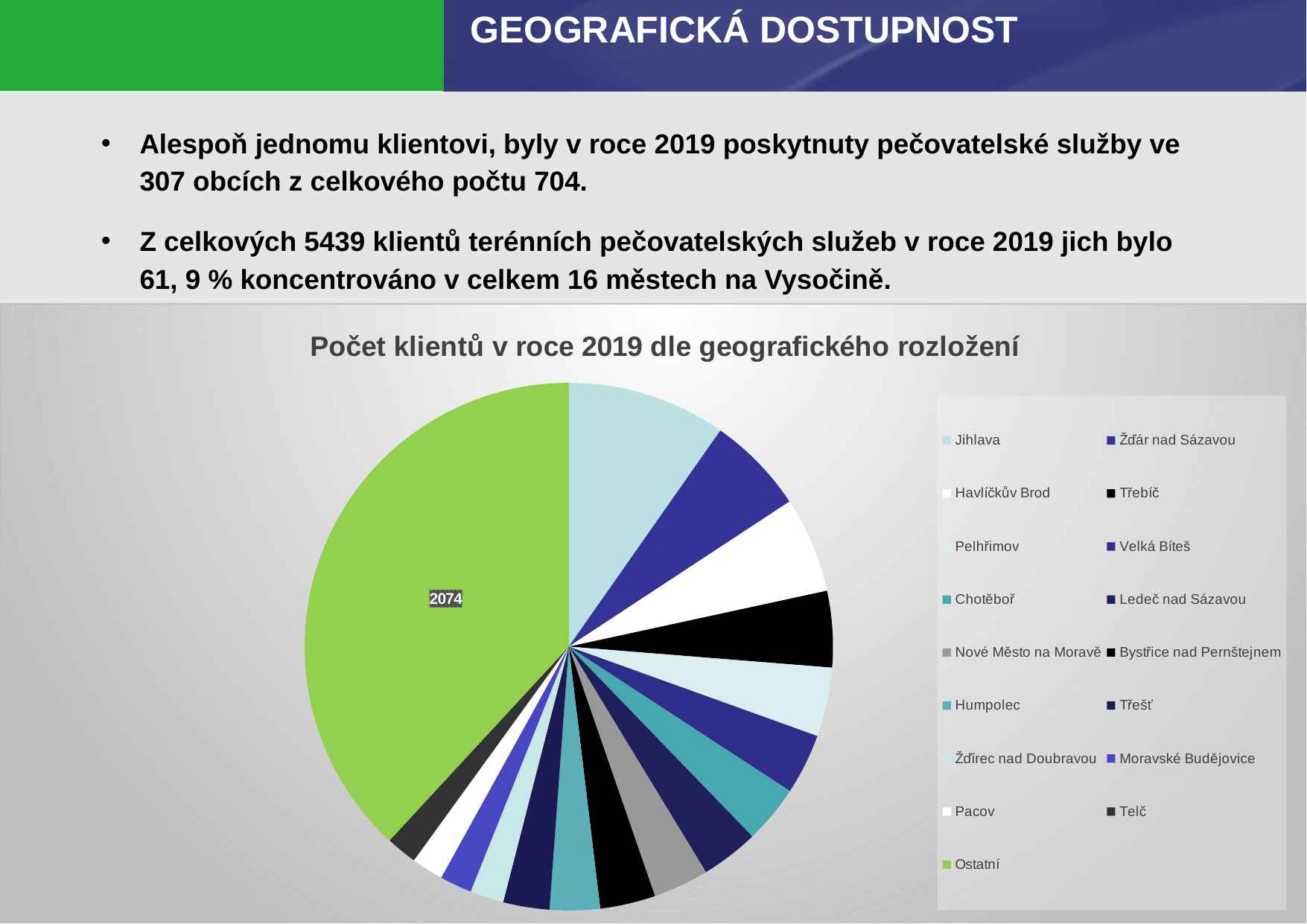
What value is shown for the Ostatní slice? 2074 How many categories does the legend list? 17 Which slice is larger, Jihlava or Žďár nad Sázavou? Jihlava Which category has the largest slice of the pie? Ostatní What colour is the Ostatní slice? green Which is the only slice with a printed data label? Ostatní What kind of chart is shown on the slide? pie chart Which slice is larger, Ostatní or Jihlava? Ostatní Which slice is larger, Jihlava or Havlíčkův Brod? Jihlava What is the title of the chart? Počet klientů v roce 2019 dle geografického rozložení